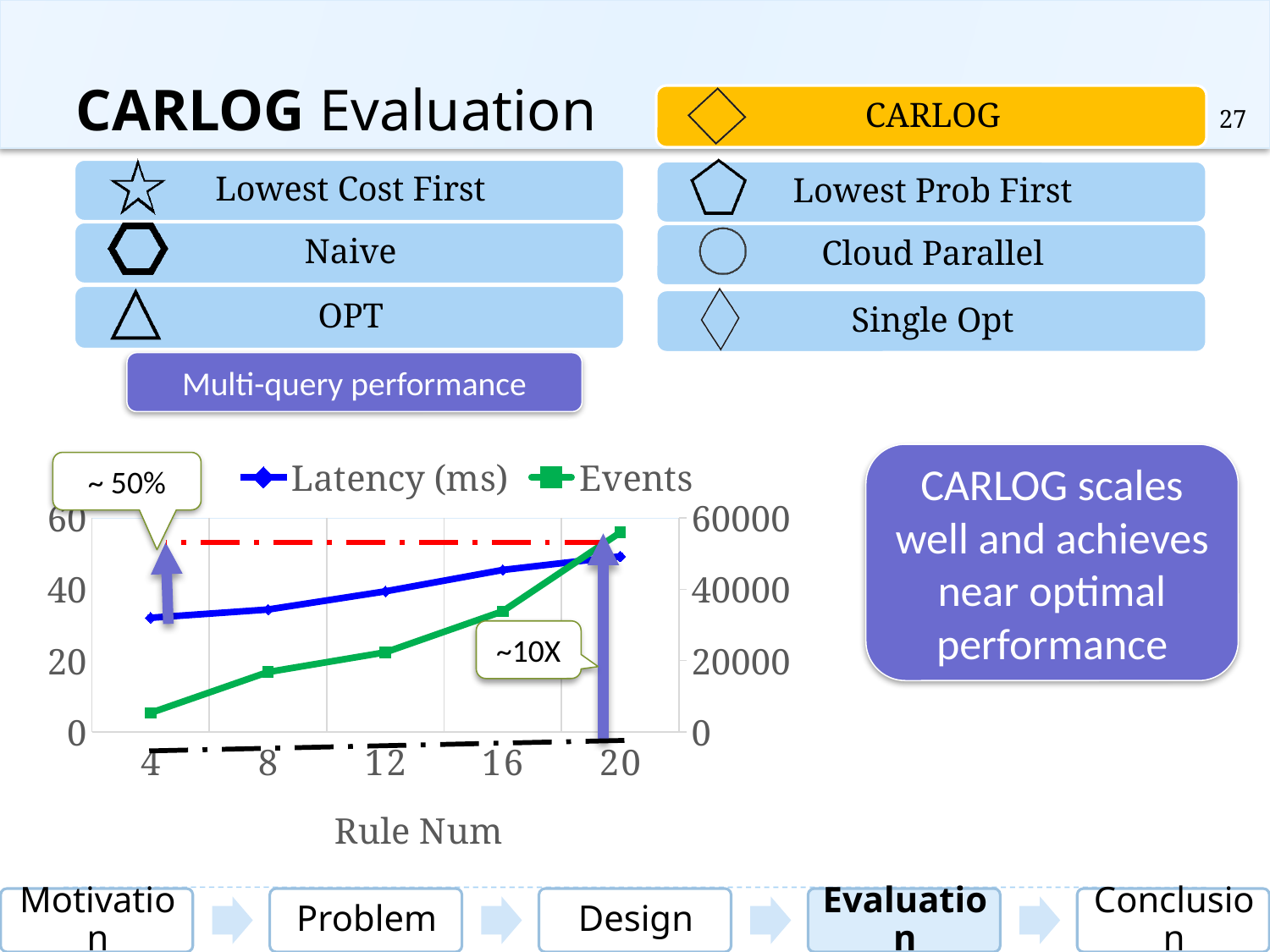
What kind of chart is shown on the slide? line chart Does the Latency (ms) series rise or fall as Rule Num increases? rise Does the Events series rise or fall as Rule Num increases? rise Is the Latency (ms) value at Rule Num 4 greater or less than 40? less Is the Events value at Rule Num 20 greater or less than 40000? greater At which Rule Num is the Events value highest? 20 How many Rule Num values are plotted along the x axis? 5 How many series does the chart legend list? 2 Is the Events value at Rule Num 4 greater or less than 20000? less At which Rule Num is the Latency (ms) value lowest? 4 What are the two series named in the chart legend? Latency (ms) and Events What is the title of the x axis of the chart? Rule Num